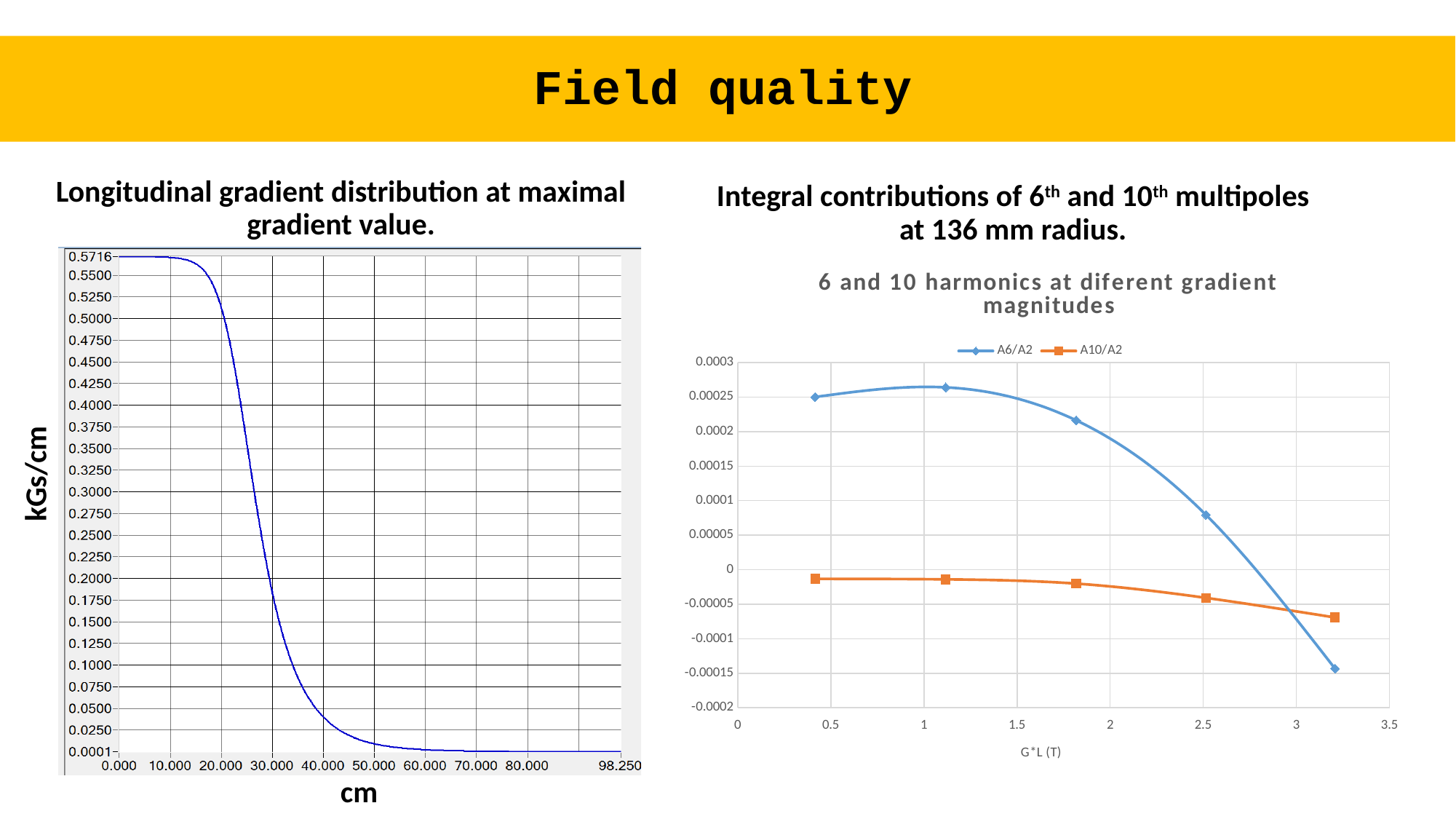
On the right chart, is the A6/A2 value at the smallest G*L (about 0.4 T) greater or less than 0.0002? greater On the right chart, does the A10/A2 series rise or fall as G*L increases? Fall On the right chart, how many data points are plotted for the A6/A2 series? 5 On the right chart, is the A10/A2 value at the largest G*L (about 3.2 T) greater or less than -0.00005? less On the left chart, what is the maximum gradient value shown on the y axis where the curve starts? 0.5716 On the left chart, does the gradient rise or fall as the position in cm increases? Fall On the right chart, how many series does the legend list? 2 What kind of chart is the right chart titled '6 and 10 harmonics at diferent gradient magnitudes'? Line chart On the right chart, what are the two series named in the legend? A6/A2 and A10/A2 On the right chart, is the A6/A2 value at the largest G*L (about 3.2 T) greater or less than -0.0001? less On the right chart, at the smallest G*L value, which series has the larger value, A6/A2 or A10/A2? A6/A2